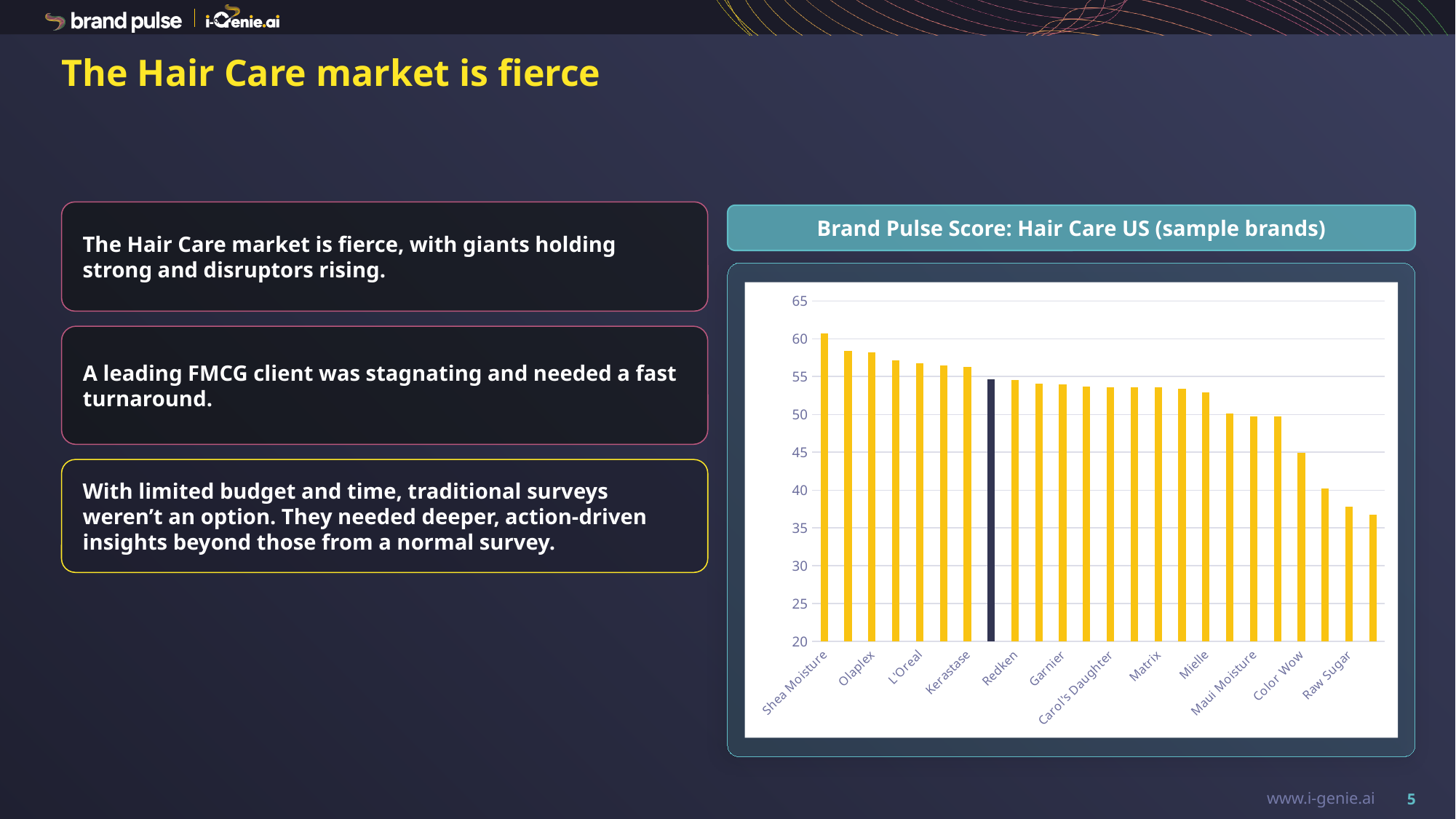
What kind of chart is shown on the slide? bar chart Which brand has the highest Brand Pulse Score in the chart? Shea Moisture Is the Brand Pulse Score for Raw Sugar greater or less than 40? less Is the Brand Pulse Score for Olaplex greater or less than 55? greater What is the title of the chart? Brand Pulse Score: Hair Care US (sample brands) Which brand has the larger Brand Pulse Score, Olaplex or Color Wow? Olaplex Is the Brand Pulse Score for Maui Moisture greater or less than 55? less Do the Brand Pulse Scores rise or fall moving from left to right along the x axis? fall Which brand has the larger Brand Pulse Score, Shea Moisture or Raw Sugar? Shea Moisture